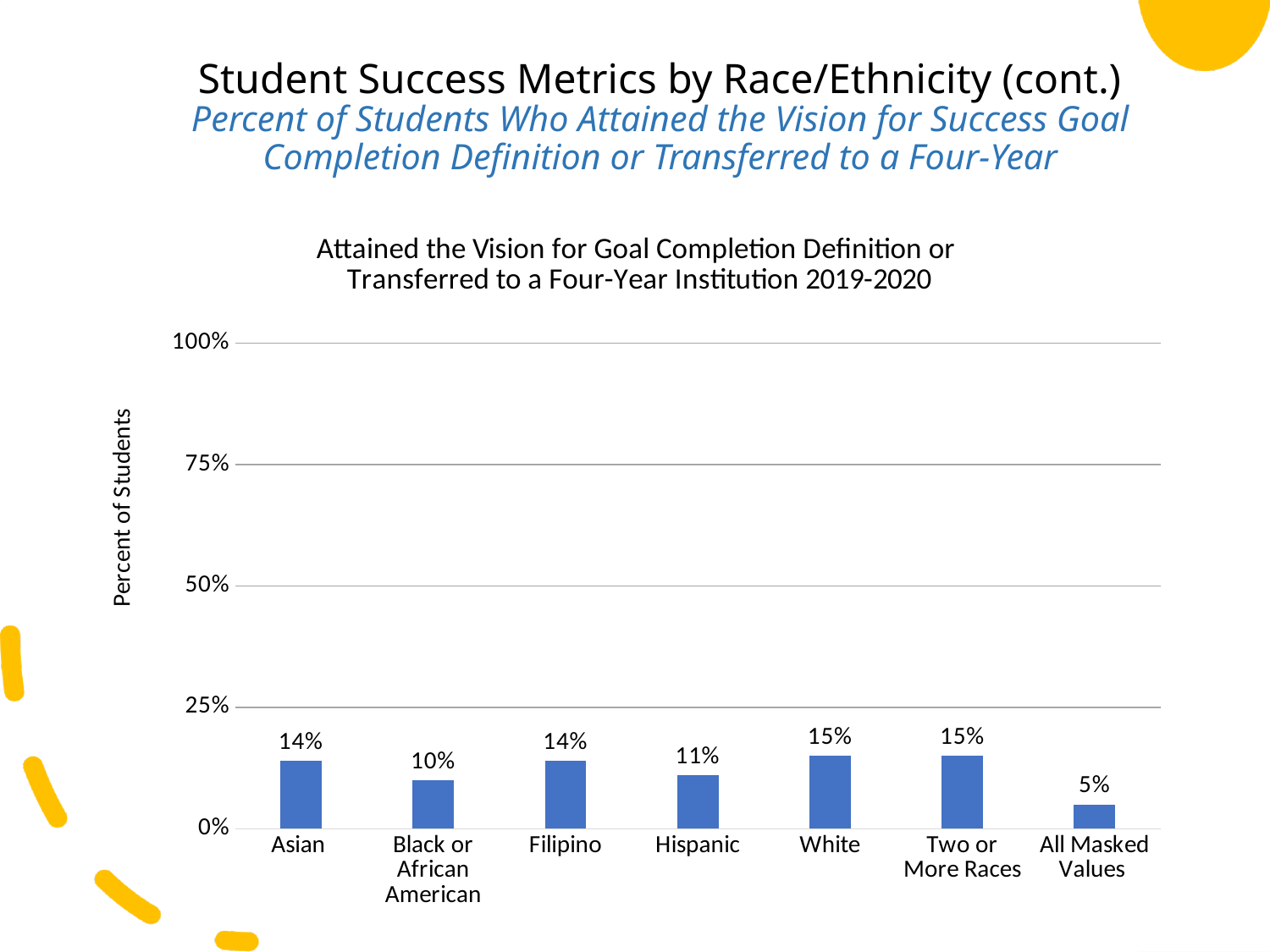
What is the value for Hispanic? 11% What is the value for Black or African American? 10% What is the value for Asian? 14% What is the difference between the values for Filipino and All Masked Values? 9% Which category has the lowest value? All Masked Values Which is larger, the value for Hispanic or the value for Two or More Races? Two or More Races What is the label on the vertical axis? Percent of Students Is the value for White greater or less than 25%? less How many categories are shown on the x axis? 7 What is the value for All Masked Values? 5% What kind of chart is shown on the slide? bar chart What is the difference between the values for White and Black or African American? 5%